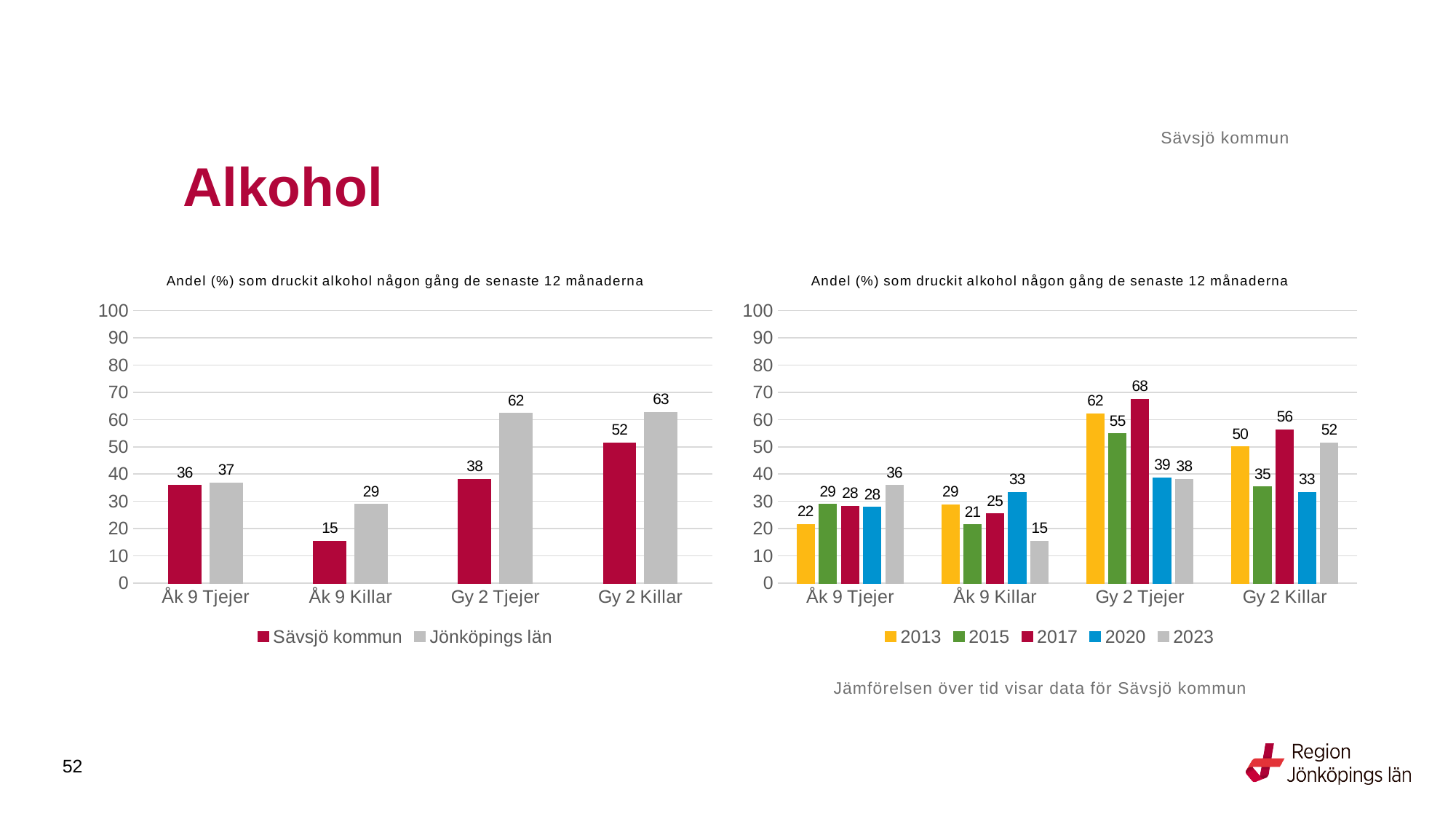
In the left chart, how many series does the legend list? 2 In the right chart, what is the difference between the 2013 and 2023 values for Gy 2 Tjejer? 24 In the left chart, what is the value for Sävsjö kommun for Åk 9 Killar? 15 In the right chart, which year has the lowest value for Gy 2 Killar? 2020 In the right chart, what is the value for 2023 for Åk 9 Killar? 15 In the left chart, which category has the highest value for Jönköpings län? Gy 2 Killar What kind of chart is the left chart? Bar chart In the left chart, what is the value for Jönköpings län for Gy 2 Tjejer? 62 In the left chart, what is the difference between Jönköpings län and Sävsjö kommun for Gy 2 Tjejer? 24 In the right chart, how many series does the legend list? 5 In the right chart, which is larger for Åk 9 Tjejer: the value for 2013 or the value for 2023? 2023 In the right chart, what is the value for 2017 for Gy 2 Tjejer? 68